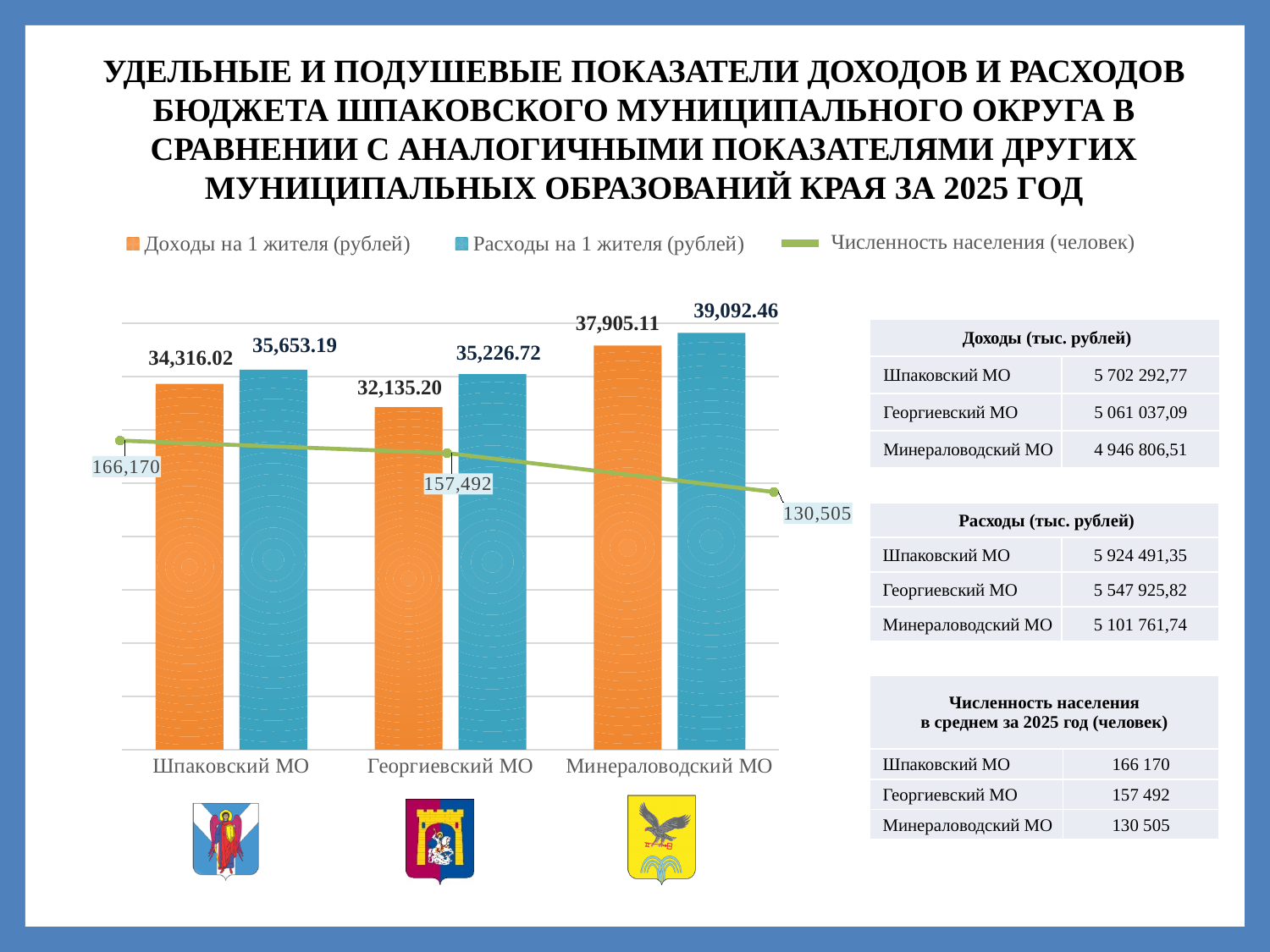
What is the Численность населения (человек) value for Минераловодский МО on the chart? 130,505 Does the Численность населения line rise or fall from Шпаковский МО to Минераловодский МО? fall What is the difference between Расходы на 1 жителя and Доходы на 1 жителя for Минераловодский МО? 1,187.35 How many series does the chart legend list? 3 What is the value of Расходы на 1 жителя (рублей) for Георгиевский МО? 35,226.72 What colour are the bars for Доходы на 1 жителя (рублей)? orange Which is larger for Шпаковский МО: Доходы на 1 жителя or Расходы на 1 жителя? Расходы на 1 жителя What is the value of Доходы на 1 жителя (рублей) for Шпаковский МО? 34,316.02 How many categories are shown on the x axis of the chart? 3 What is the difference in Численность населения between Шпаковский МО and Минераловодский МО? 35,665 Which category has the highest Расходы на 1 жителя (рублей)? Минераловодский МО Which category has the lowest Доходы на 1 жителя (рублей)? Георгиевский МО